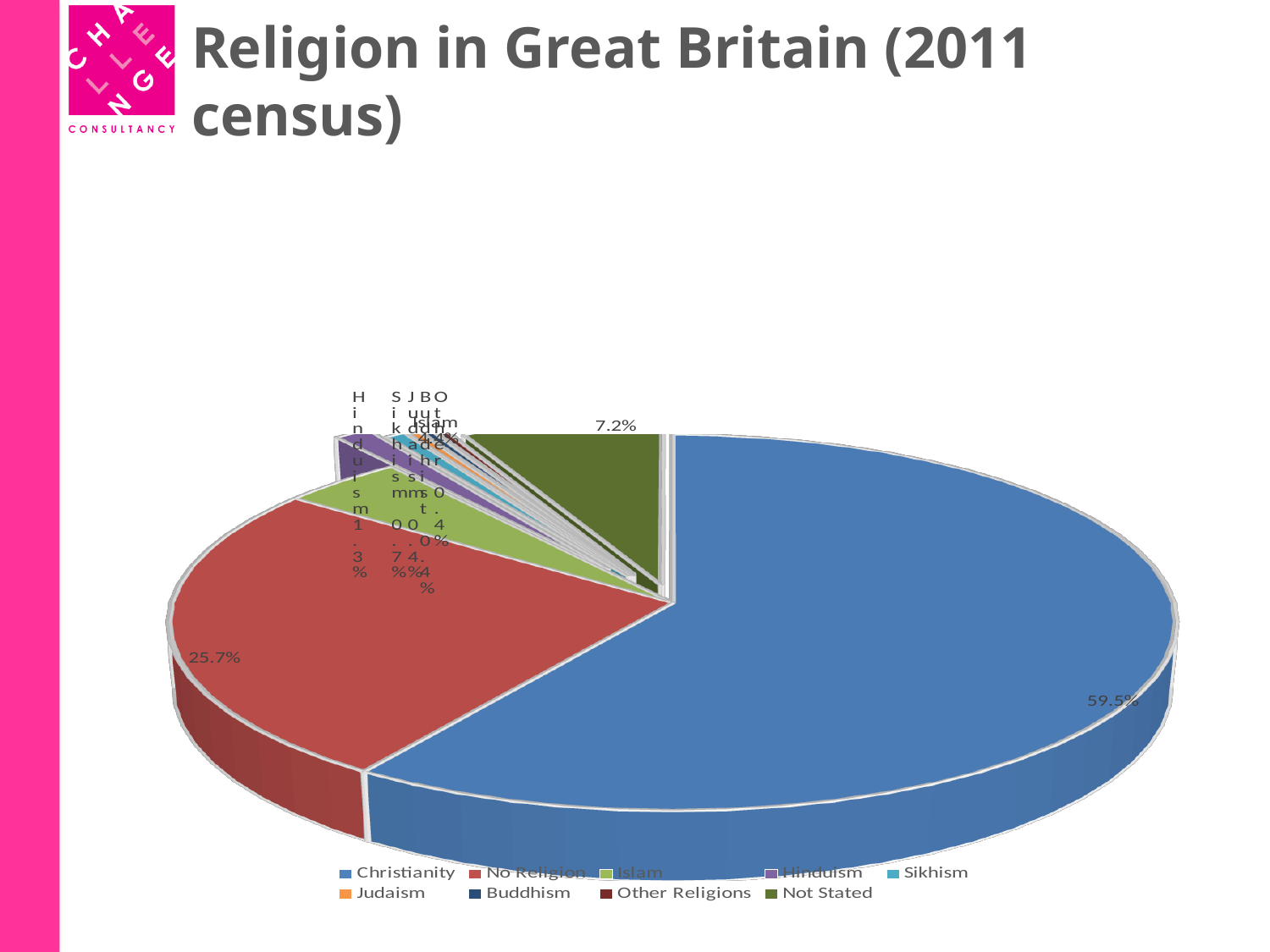
What share of the pie is Christianity? 59.5% What colour is the Christianity slice? blue What share of the pie is No Religion? 25.7% What is the title of the chart? Religion in Great Britain (2011 census) What is the difference in percentage points between Christianity and No Religion? 33.8% What is the difference in percentage points between No Religion and Not Stated? 18.5% What share of the pie is Not Stated? 7.2% Which is larger, the slice for Christianity or the slice for No Religion? Christianity How many categories does the legend list? 9 What kind of chart is shown on the slide? pie chart What share of the pie is Hinduism? 1.3% Which category has the largest slice of the pie? Christianity